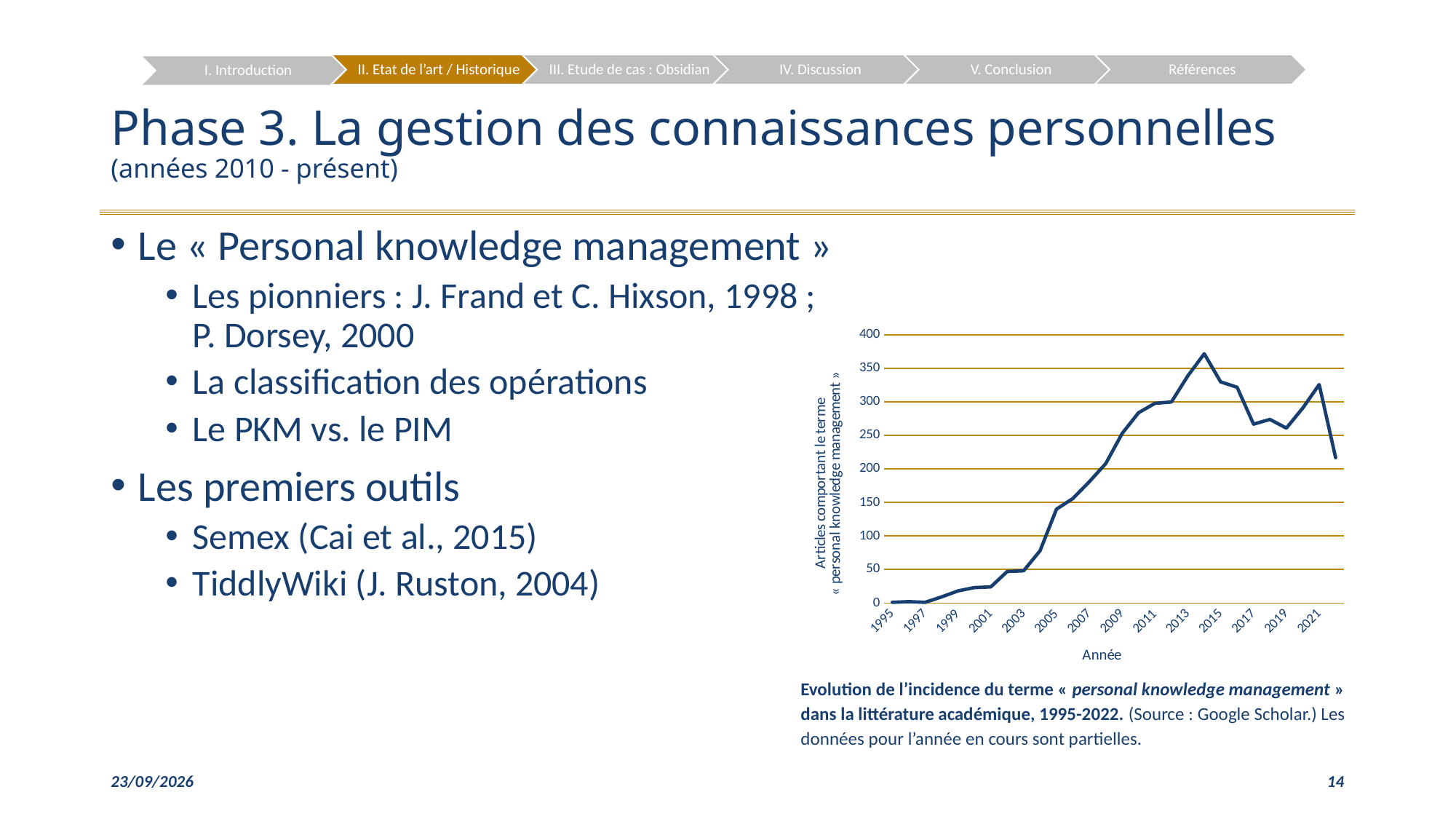
Which year has the larger value, 2001 or 2009? 2009 In which year does the line reach its highest value? 2014 Is the value for 2009 greater or less than 200? greater How many year labels are shown on the x axis? 14 Is the value for 2011 greater or less than 250? greater What is the label of the x axis of the chart? Année Is the value for 1999 greater or less than 50? less What kind of chart is shown on the slide? line chart Do the values generally rise or fall between 1995 and 2014? rise What is the label of the y axis of the chart? Articles comportant le terme « personal knowledge management »